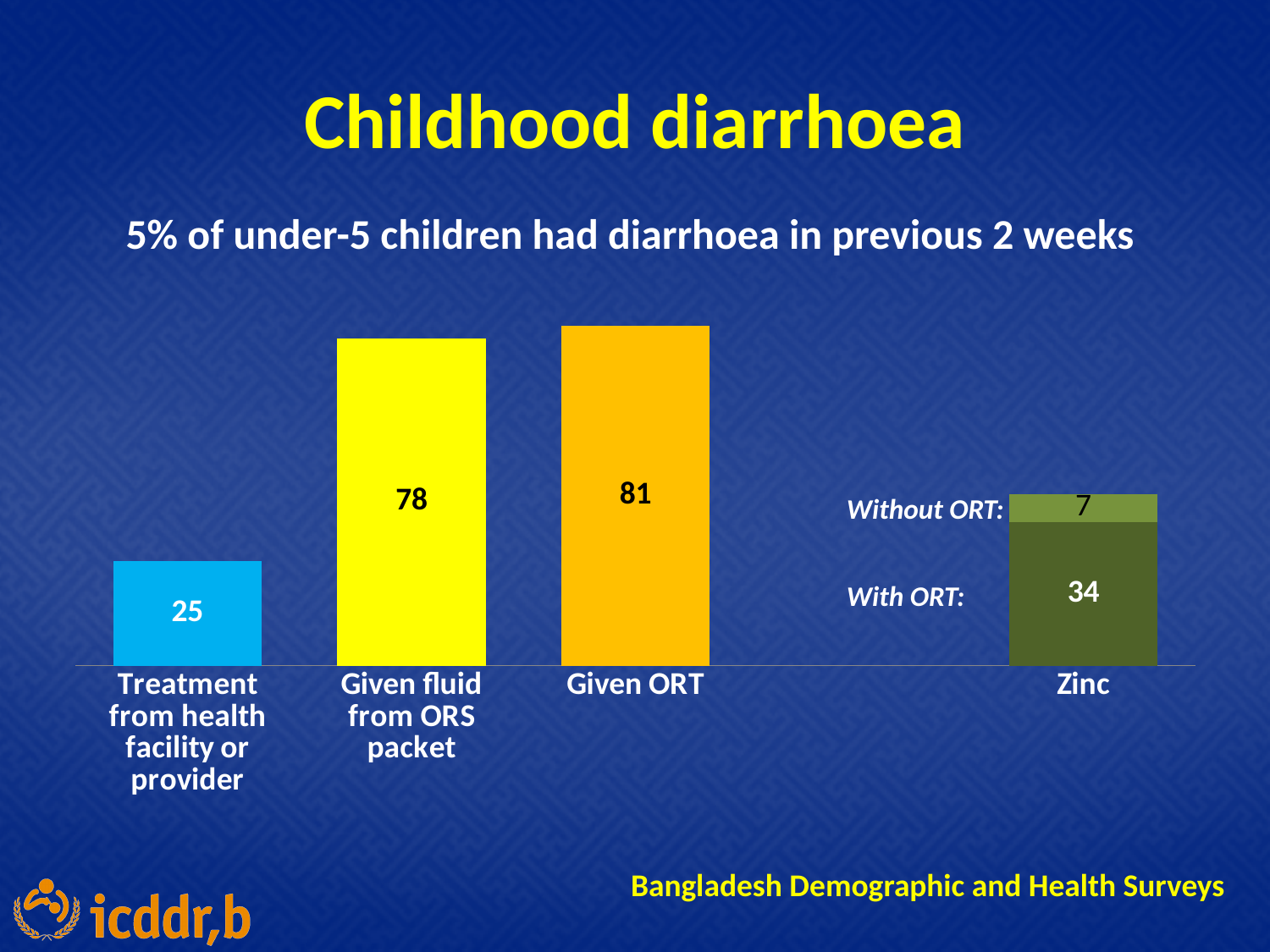
What is the value for Given fluid from ORS packet? 78 What is the difference between the values for Given ORT and Given fluid from ORS packet? 3 What is the Without ORT value in the Zinc bar? 7 Which is larger, the value for Given fluid from ORS packet or the value for Treatment from health facility or provider? Given fluid from ORS packet What is the value for Treatment from health facility or provider? 25 What kind of chart is shown on the slide? Bar chart Which category has the lowest total value? Treatment from health facility or provider What is the total of the stacked Zinc bar? 41 Which category has the highest value? Given ORT How many categories are shown on the x axis? 4 What is the With ORT value in the Zinc bar? 34 What is the value for Given ORT? 81